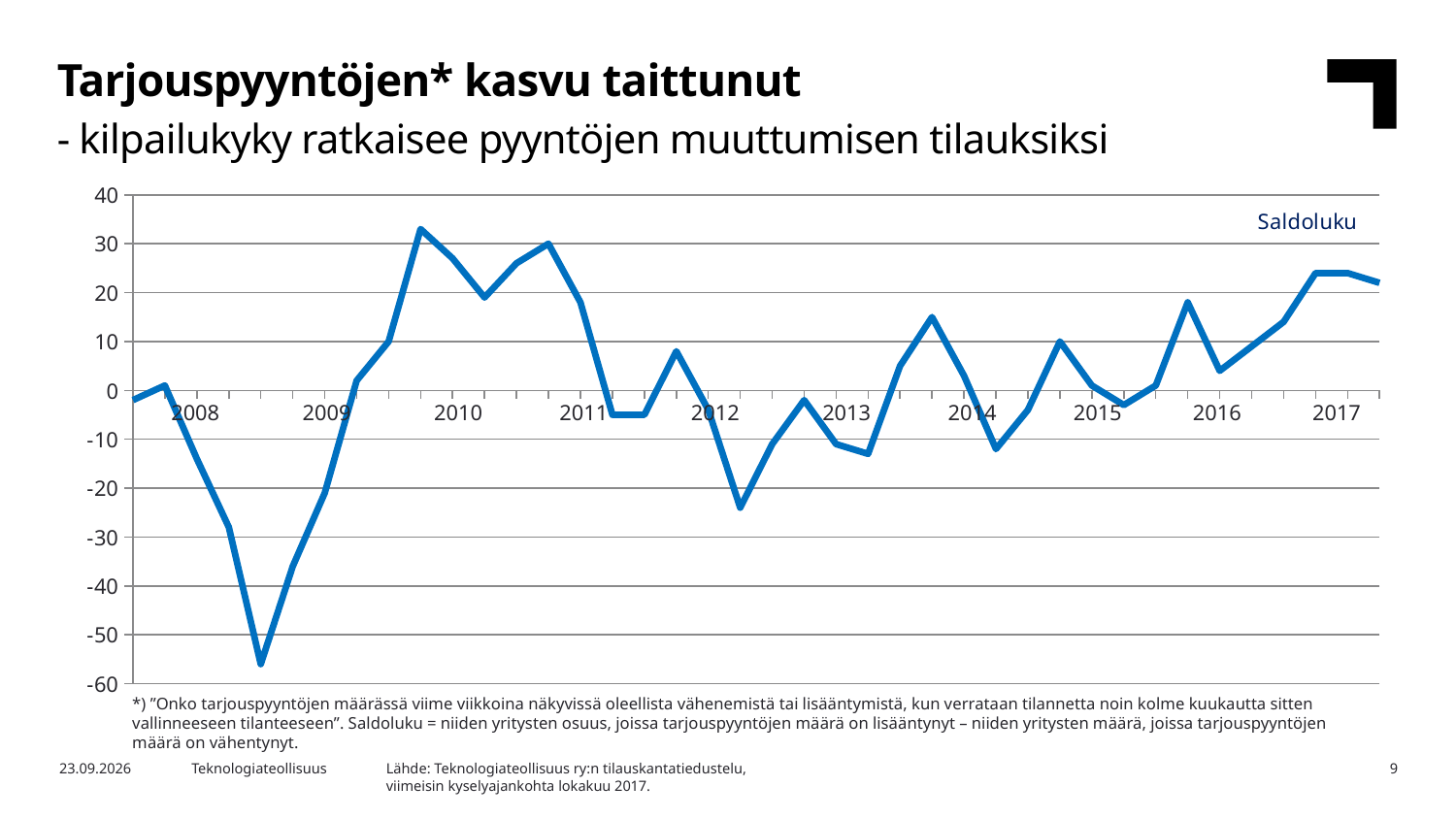
Is the value at the 2011 label greater or less than 10? greater Is the value at the 2016 label greater or less than 0? greater What is the highest value shown on the y axis? 40 Is the lowest point of the line greater or less than -50? less Does the line rise or fall between the 2015 label and the 2017 label? rise How many year labels are shown on the x axis? 10 What kind of chart is shown on the slide? line chart Does the line rise or fall between the 2008 label and its lowest point? fall